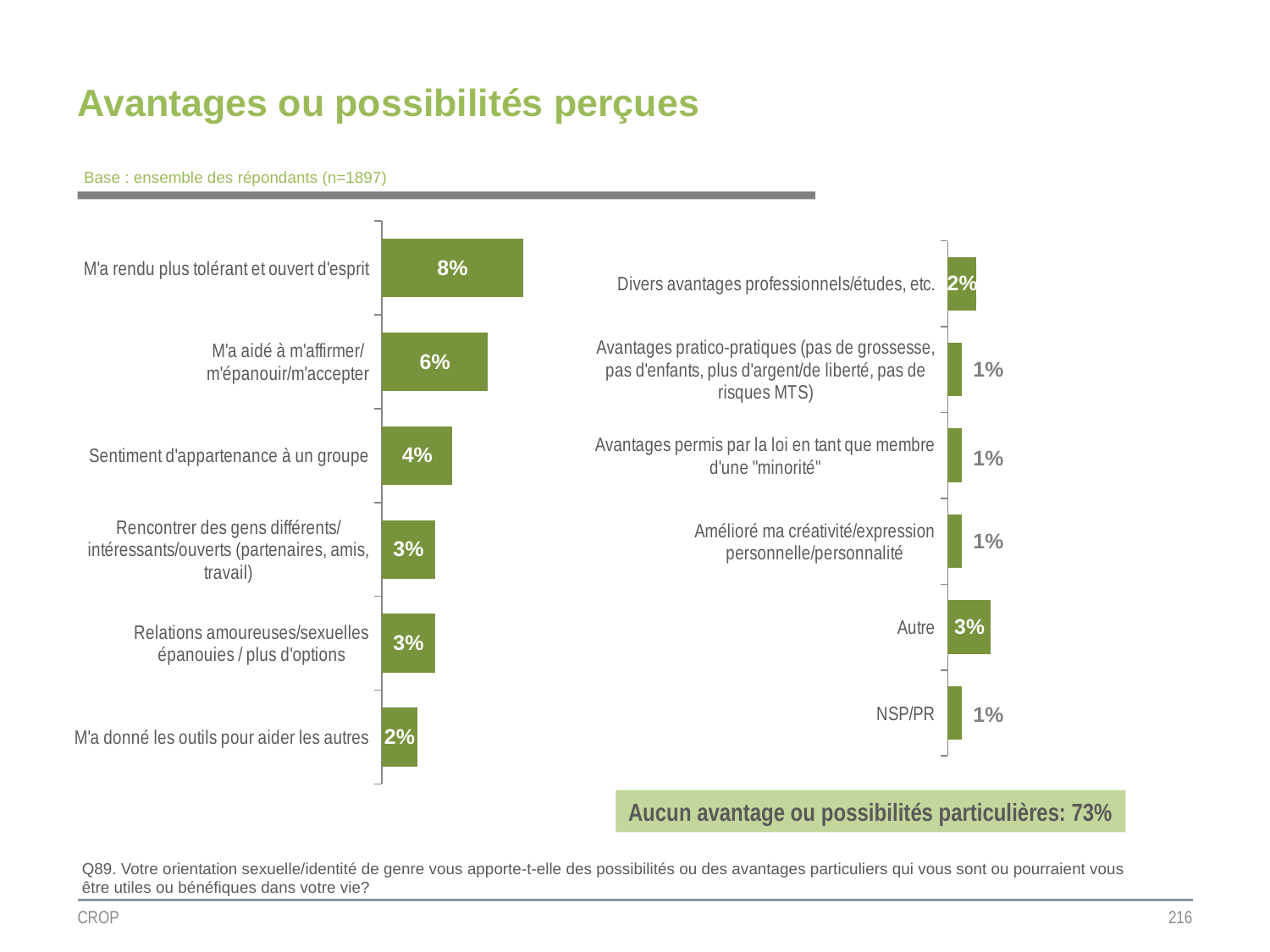
In the right chart, what is the value for "Autre"? 3% In the left chart, what is the difference between "M'a rendu plus tolérant et ouvert d'esprit" and "M'a aidé à m'affirmer/m'épanouir/m'accepter"? 2% In the left chart, which category has the highest value? M'a rendu plus tolérant et ouvert d'esprit In the right chart, which category has the highest value? Autre How many categories are shown in the left chart? 6 In the right chart, which is larger: "Autre" or "NSP/PR"? Autre In the right chart, what is the value for "Divers avantages professionnels/études, etc."? 2% In the left chart, which category has the lowest value? M'a donné les outils pour aider les autres What type of chart is the left chart? Bar chart In the left chart, what is the value for "Sentiment d'appartenance à un groupe"? 4% In the left chart, what is the value for "M'a rendu plus tolérant et ouvert d'esprit"? 8% How many categories are shown in the right chart? 6